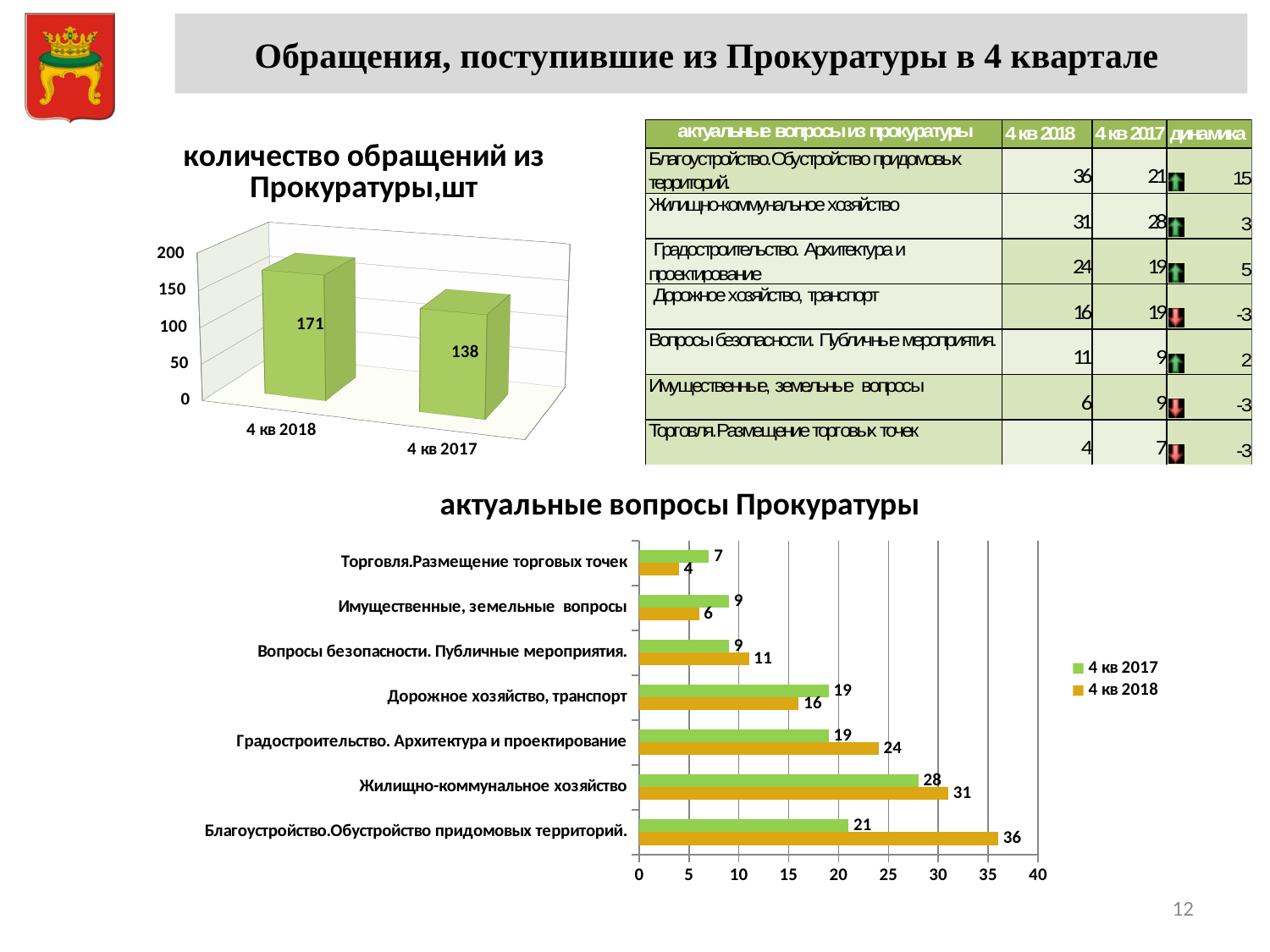
What kind of chart is 'актуальные вопросы Прокуратуры'? Bar chart In the chart 'актуальные вопросы Прокуратуры', how many series does the legend list? 2 In the chart 'количество обращений из Прокуратуры,шт', what is the value for 4 кв 2018? 171 In the chart 'количество обращений из Прокуратуры,шт', what is the value for 4 кв 2017? 138 In the chart 'актуальные вопросы Прокуратуры', which is larger for 'Имущественные, земельные вопросы': the 4 кв 2017 value or the 4 кв 2018 value? 4 кв 2017 In the chart 'актуальные вопросы Прокуратуры', what is the 4 кв 2018 value for 'Благоустройство.Обустройство придомовых территорий.'? 36 In the chart 'актуальные вопросы Прокуратуры', what is the 4 кв 2017 value for 'Дорожное хозяйство, транспорт'? 19 In the chart 'актуальные вопросы Прокуратуры', which category has the lowest 4 кв 2018 value? Торговля.Размещение торговых точек In the chart 'количество обращений из Прокуратуры,шт', how many bars are plotted? 2 In the chart 'актуальные вопросы Прокуратуры', which category has the highest 4 кв 2018 value? Благоустройство.Обустройство придомовых территорий. In the chart 'актуальные вопросы Прокуратуры', what is the difference between the 4 кв 2018 and 4 кв 2017 values for 'Градостроительство. Архитектура и проектирование'? 5 In the chart 'количество обращений из Прокуратуры,шт', what is the difference between the 4 кв 2018 and 4 кв 2017 values? 33